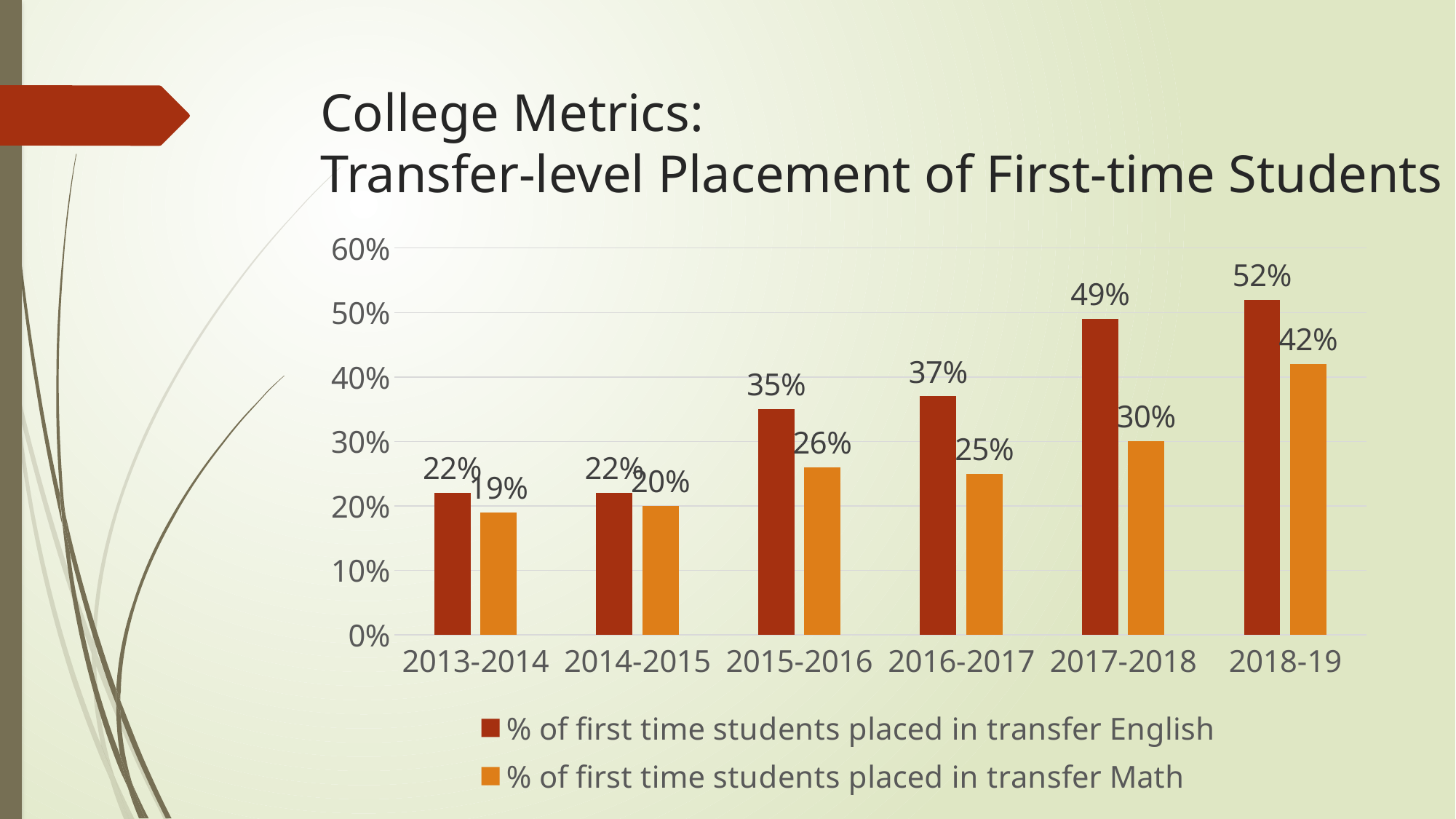
What is the value for transfer Math placement in 2018-19? 42% What percentage of first time students were placed in transfer English in 2017-2018? 49% How many academic years are shown on the x axis? 6 What kind of chart is shown on the slide? bar chart Does the percentage of first time students placed in transfer English rise or fall from 2013-2014 to 2018-19? rise What percentage of first time students were placed in transfer Math in 2015-2016? 26% How many series does the legend list? 2 Which year has the lowest percentage of first time students placed in transfer Math? 2013-2014 What is the difference between the transfer English and transfer Math placement percentages in 2017-2018? 19% Which year has the highest percentage of first time students placed in transfer English? 2018-19 Is the percentage of first time students placed in transfer Math in 2018-19 greater or less than 40%? greater Which is larger in 2016-2017: the percentage placed in transfer English or in transfer Math? transfer English